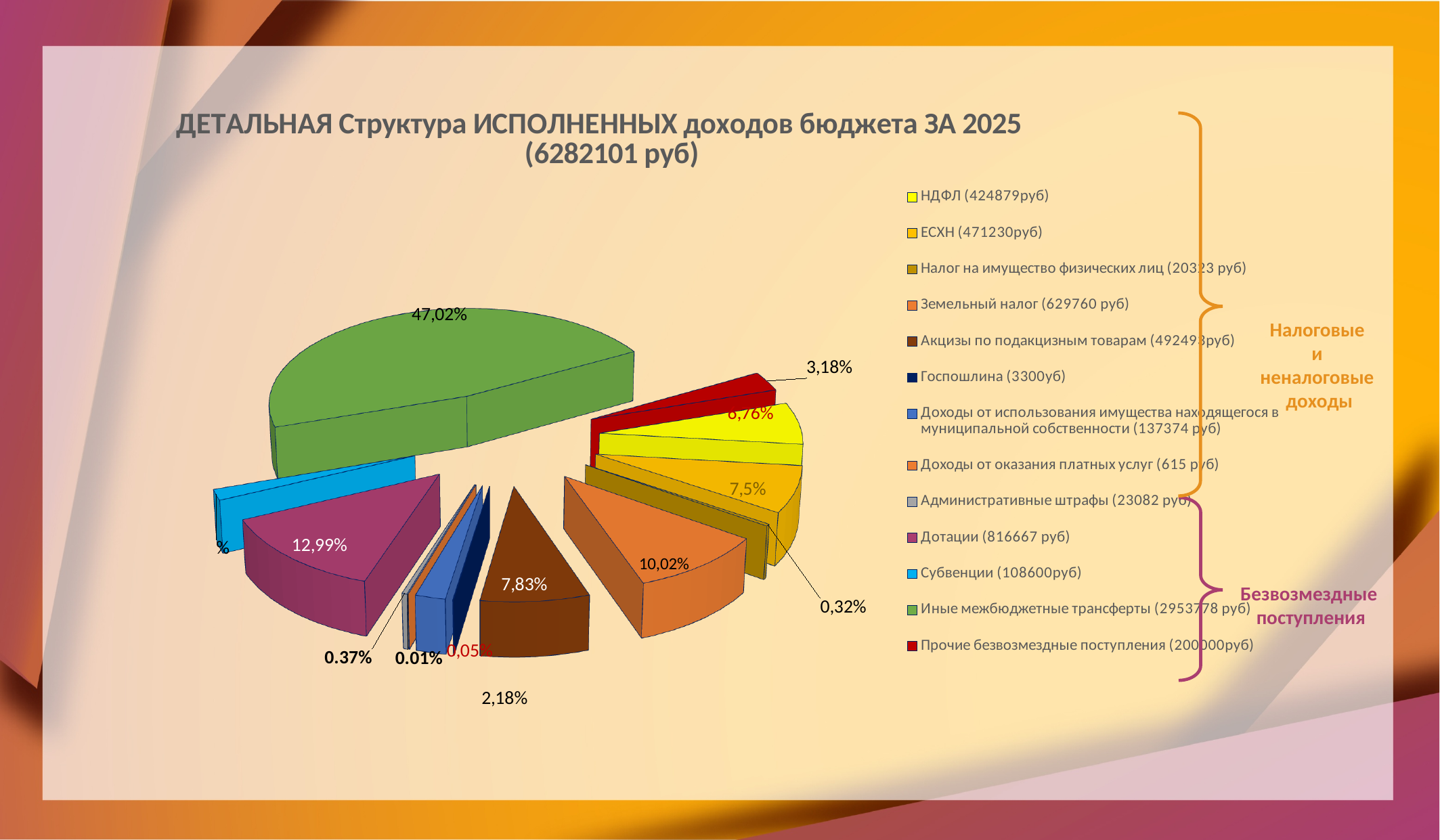
What is the total budget revenue amount shown in the chart title? 6282101 руб What share of the pie does the largest slice (Иные межбюджетные трансферты, green) have? 47,02% How many categories does the legend of the pie chart list? 13 Which category has the largest slice of the pie? Иные межбюджетные трансферты What kind of chart is shown on the slide? pie chart What amount in rubles does the legend give for Субвенции? 108600руб What share of the pie does the Дотации (purple) slice have? 12,99% What is the smallest percentage label shown on the pie chart? 0.01% What amount in rubles does the legend give for Земельный налог? 629760 руб What is the difference in percentage points between the 47,02% slice and the 12,99% slice? 34,03% What amount in rubles does the legend give for Дотации? 816667 руб Which is larger: the Дотации slice (12,99%) or the Земельный налог slice (10,02%)? Дотации